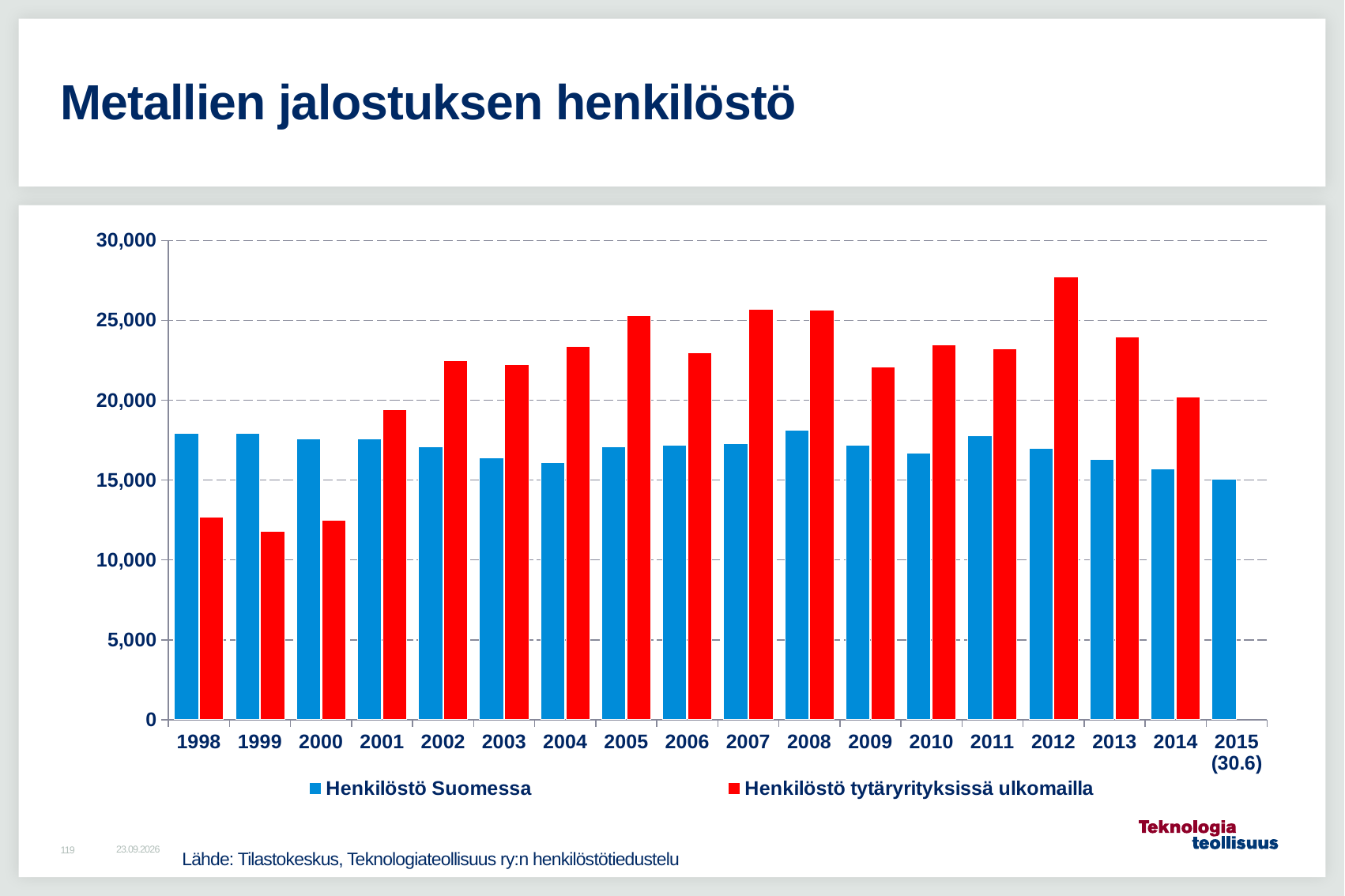
In 1998, which is larger: Henkilöstö Suomessa or Henkilöstö tytäryrityksissä ulkomailla? Henkilöstö Suomessa What kind of chart is shown on the slide? bar chart Which year has the highest value for Henkilöstö tytäryrityksissä ulkomailla? 2012 Which year has the lowest value for Henkilöstö Suomessa? 2015 (30.6) How many years (categories) are shown on the x axis? 18 Is the value for Henkilöstö Suomessa in 2008 greater or less than 15,000? greater Is the value for Henkilöstö tytäryrityksissä ulkomailla in 1998 greater or less than 15,000? less Is the value for Henkilöstö tytäryrityksissä ulkomailla in 2012 greater or less than 25,000? greater How many series does the legend list? 2 Which year has the lowest value for Henkilöstö tytäryrityksissä ulkomailla? 1999 Which colour represents Henkilöstö Suomessa in the chart? blue In 2005, which is larger: Henkilöstö Suomessa or Henkilöstö tytäryrityksissä ulkomailla? Henkilöstö tytäryrityksissä ulkomailla